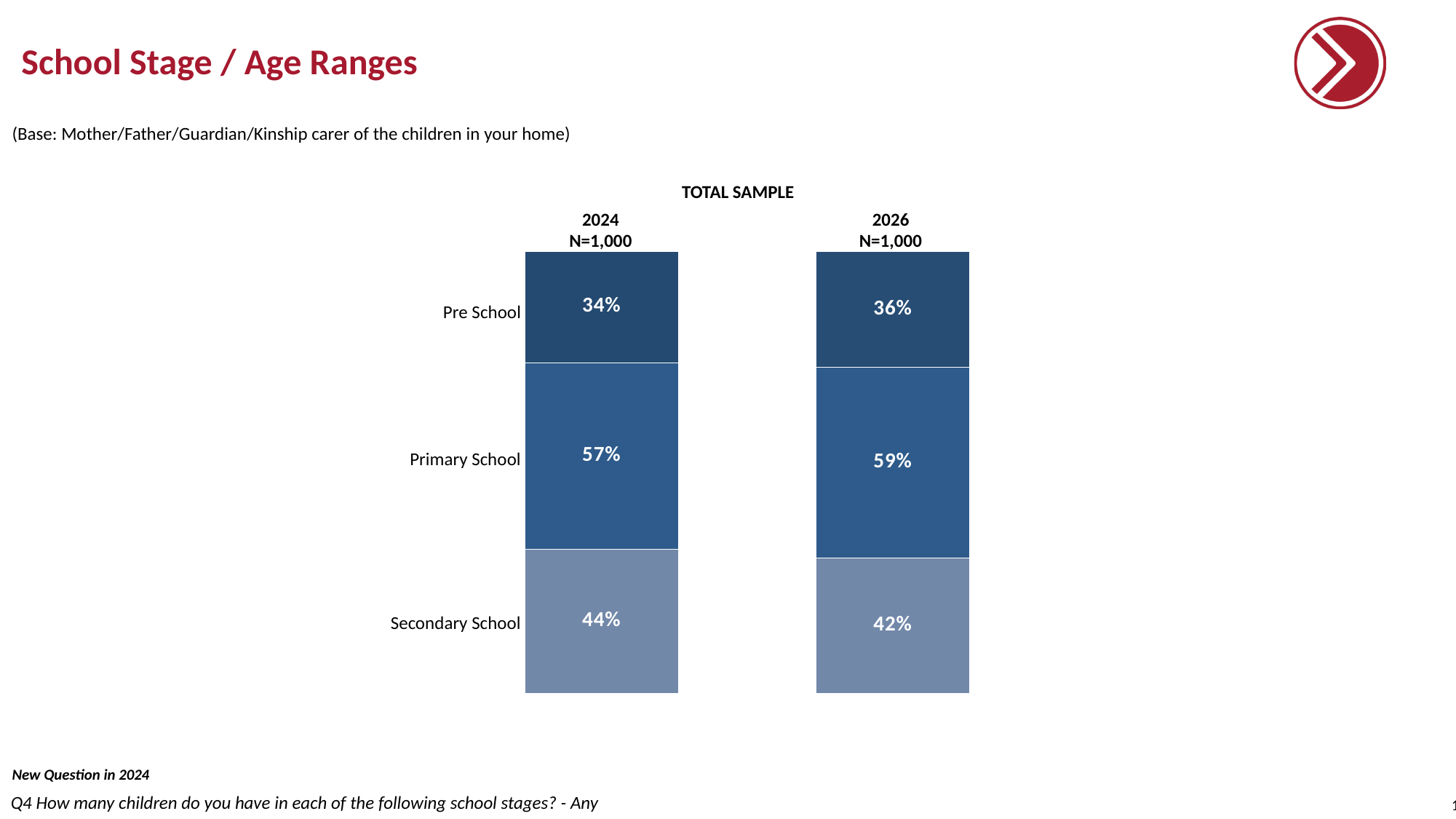
Which is larger: the Secondary School percentage in 2024 or in 2026? 2024 What is the difference between the Primary School percentages for 2026 and 2024? 2% What percentage of the 2026 sample had children in Pre School? 36% Which school stage has the highest percentage in the 2024 bar? Primary School What percentage of the 2024 sample had children in Secondary School? 44% What type of chart is shown on the slide? Stacked bar chart What percentage of the 2026 sample had children in Primary School? 59% How many school stages are shown in each bar? 3 Which school stage has the lowest percentage in the 2026 bar? Pre School What is the sample size (N) shown for the 2026 bar? N=1,000 What percentage of the 2024 sample had children in Pre School? 34% What is the heading printed above the two bars? TOTAL SAMPLE